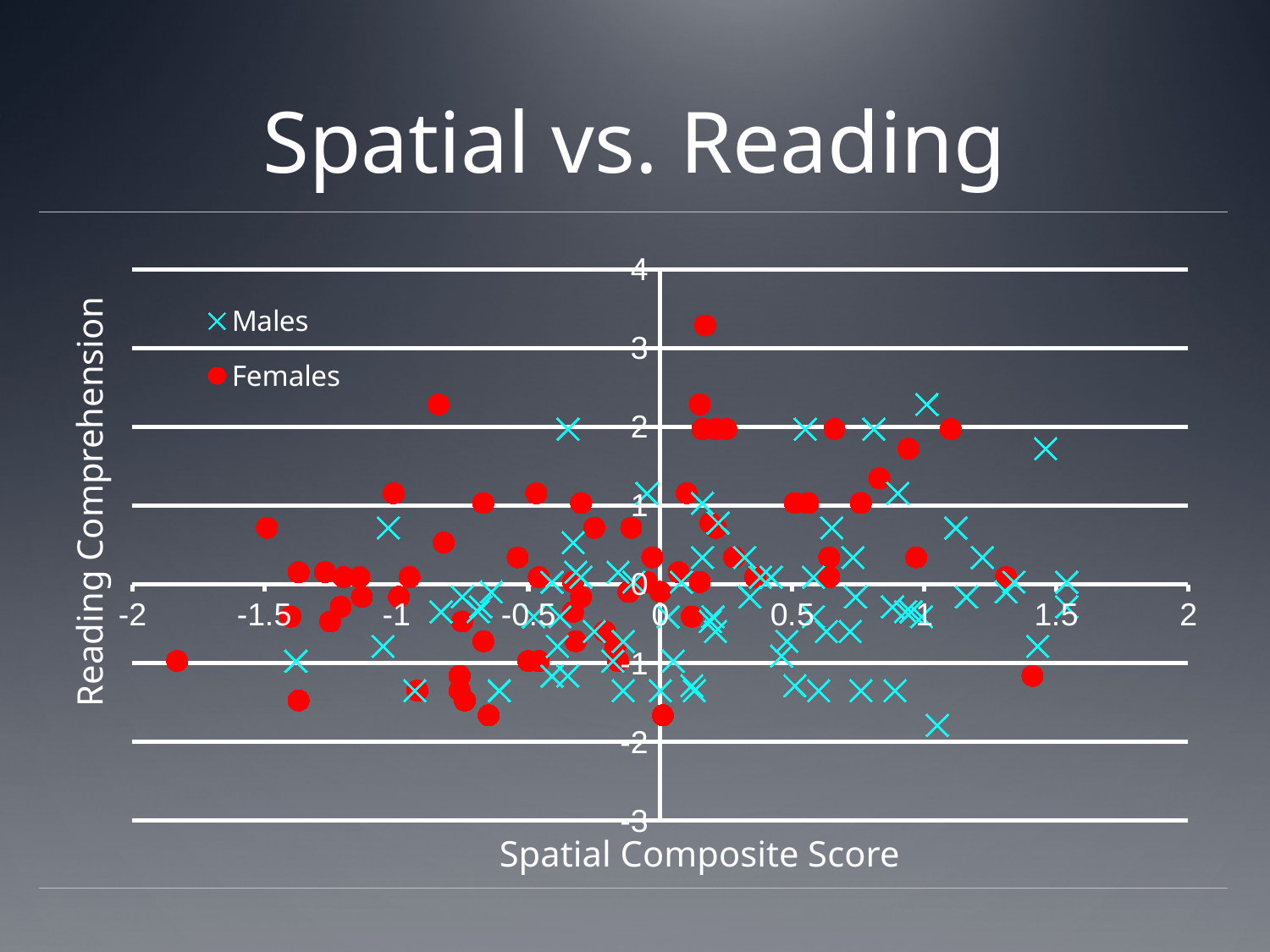
What is the label on the horizontal axis? Spatial Composite Score What kind of chart is shown on the slide? Scatter plot What is the minimum value shown on the vertical axis? -3 Is the Spatial Composite Score of the leftmost point greater or less than -1.5? less What is the maximum value shown on the vertical axis? 4 What is the range of the horizontal axis? -2 to 2 Is the lowest Reading Comprehension value on the chart greater or less than -1.5? less What is the title of the chart? Spatial vs. Reading Which series does the leftmost point on the chart belong to? Females How many series does the legend list? 2 Which series has the point with the highest Reading Comprehension value? Females Is the highest Reading Comprehension value on the chart greater or less than 3? greater